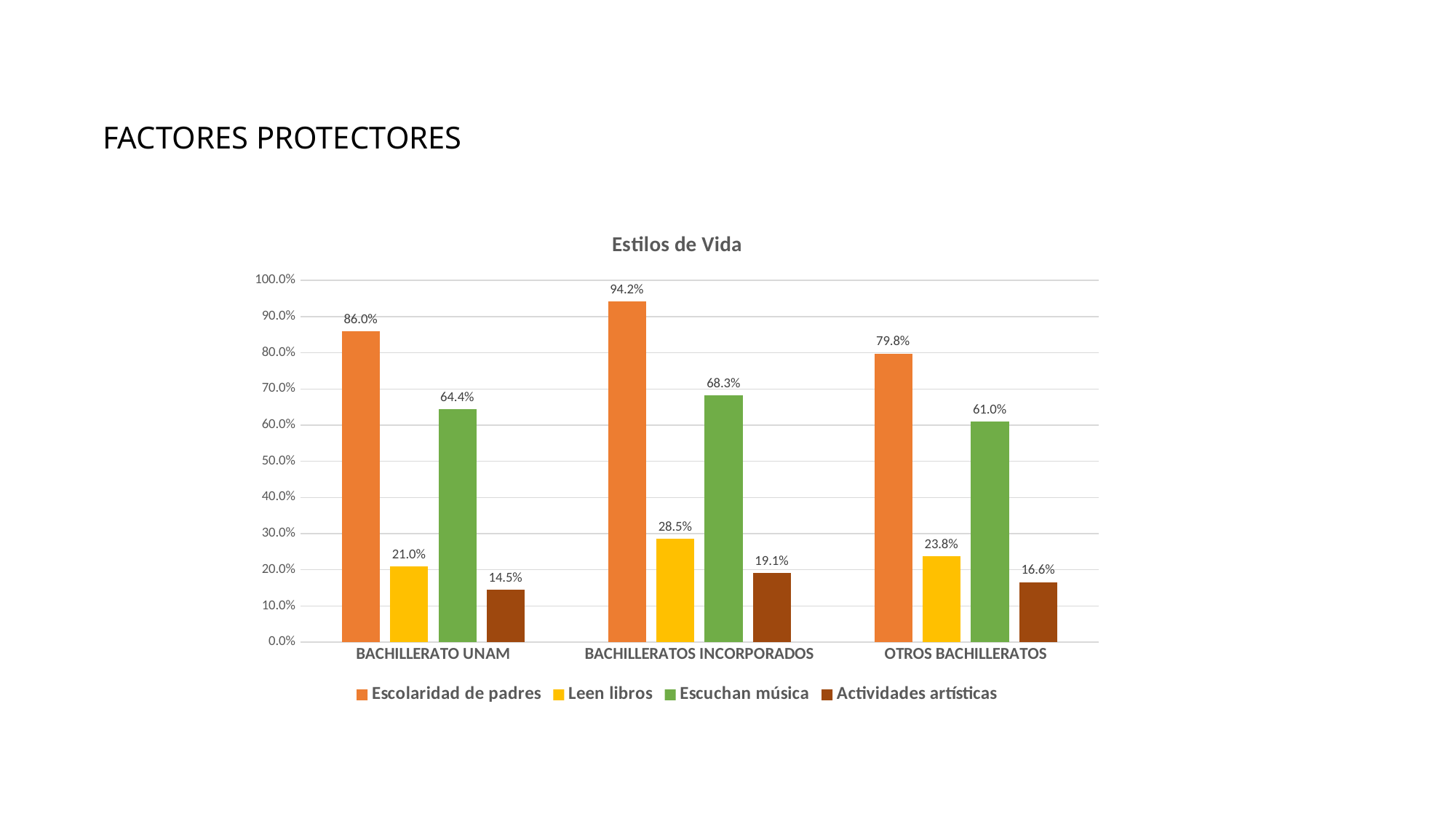
What is the value for Escolaridad de padres in BACHILLERATOS INCORPORADOS? 94.2% Which category has the highest value for Escuchan música? BACHILLERATOS INCORPORADOS What kind of chart is shown? Bar chart What is the value for Actividades artísticas in BACHILLERATO UNAM? 14.5% Which category has the lowest value for Escolaridad de padres? OTROS BACHILLERATOS What is the value for Leen libros in OTROS BACHILLERATOS? 23.8% How many categories are shown on the x axis? 3 How many series does the legend list? 4 What is the difference between Escuchan música in BACHILLERATOS INCORPORADOS and in OTROS BACHILLERATOS? 7.3% What is the title of the chart? Estilos de Vida Which is larger: Leen libros in BACHILLERATO UNAM or Leen libros in BACHILLERATOS INCORPORADOS? BACHILLERATOS INCORPORADOS Is the value for Escuchan música in BACHILLERATO UNAM greater or less than 60.0%? greater